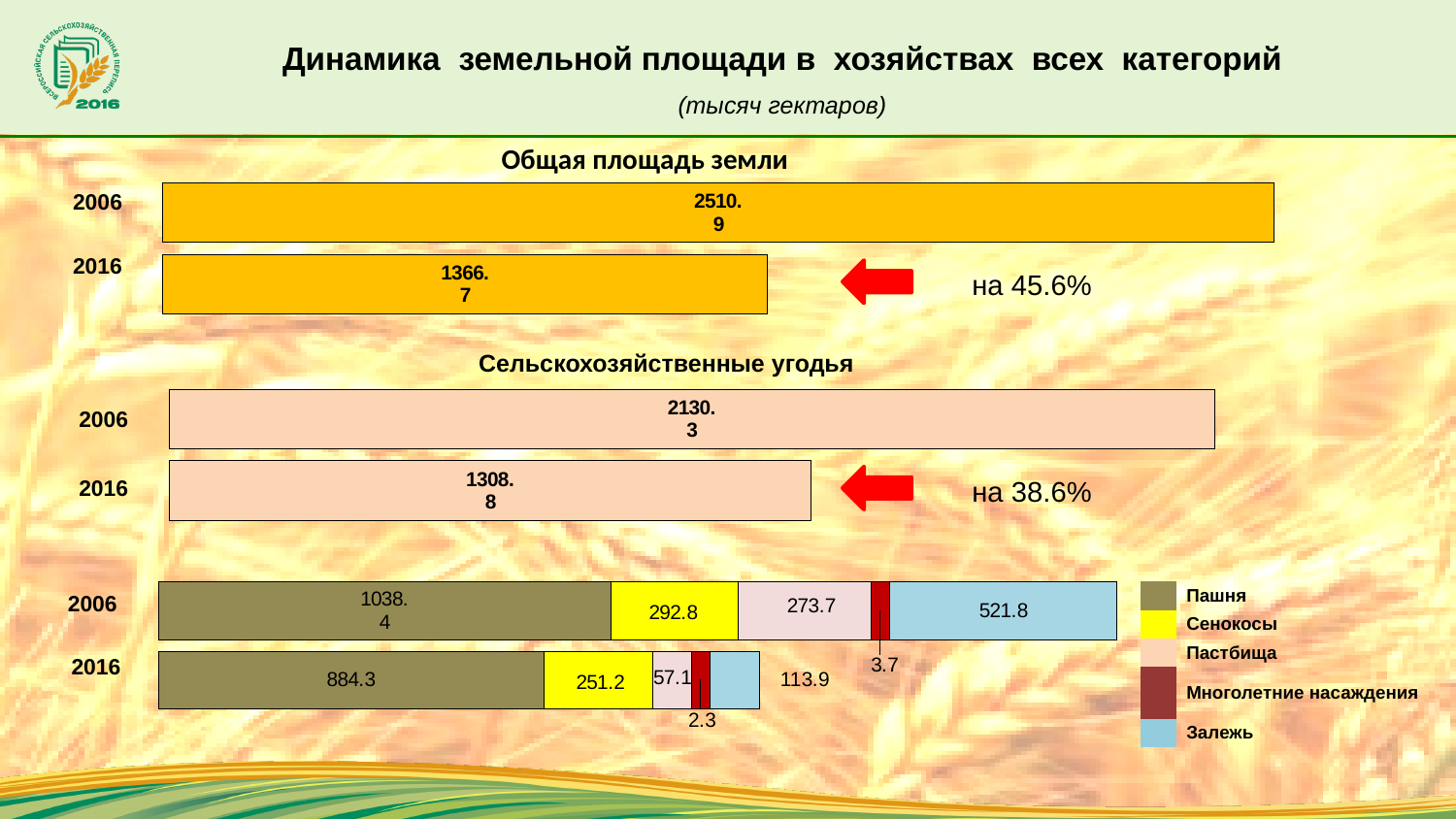
In the bottom stacked bar chart, what is the difference between the Сенокосы values for 2006 and 2016? 41.6 In the bottom stacked bar chart, how many series does the legend list? 5 In the bottom stacked bar chart, what is the value for Залежь in 2006? 521.8 In the 'Общая площадь земли' chart, what is the value for 2016? 1366.7 What kind of chart is the bottom chart on the slide? Stacked bar chart In the bottom stacked bar chart, what is the value for Пашня in 2016? 884.3 In the bottom stacked bar chart, which series has the largest value in 2006? Пашня In the 'Общая площадь земли' chart, what is the value for 2006? 2510.9 In the 'Сельскохозяйственные угодья' chart, what is the value for 2006? 2130.3 In the bottom stacked bar chart, what is the value for Многолетние насаждения in 2016? 2.3 In the 'Сельскохозяйственные угодья' chart, by what percentage did the value decrease from 2006 to 2016, as shown on the slide? на 38.6% In the 'Сельскохозяйственные угодья' chart, what is the value for 2016? 1308.8